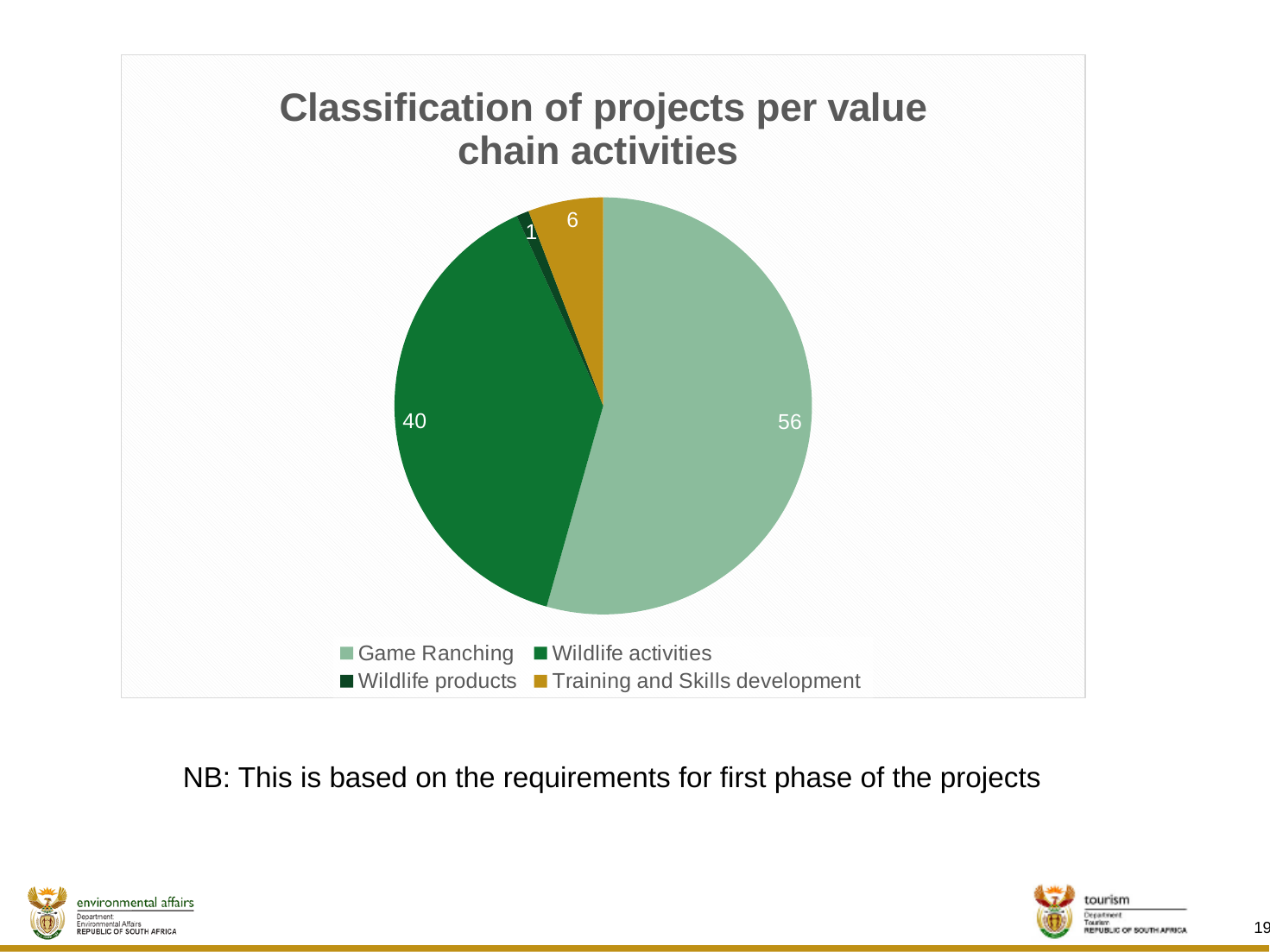
What is the difference between the values for Game Ranching and Wildlife activities? 16 What is the title of the chart? Classification of projects per value chain activities Which is larger, the value for Training and Skills development or the value for Wildlife products? Training and Skills development Which category has the smallest slice of the pie? Wildlife products Which category has the largest slice of the pie? Game Ranching What type of chart is shown on the slide? pie chart What is the value for Training and Skills development? 6 How many categories does the pie chart show? 4 What is the value for Game Ranching? 56 What is the value for Wildlife products? 1 What is the total of all the slices in the pie chart? 103 What is the value for Wildlife activities? 40